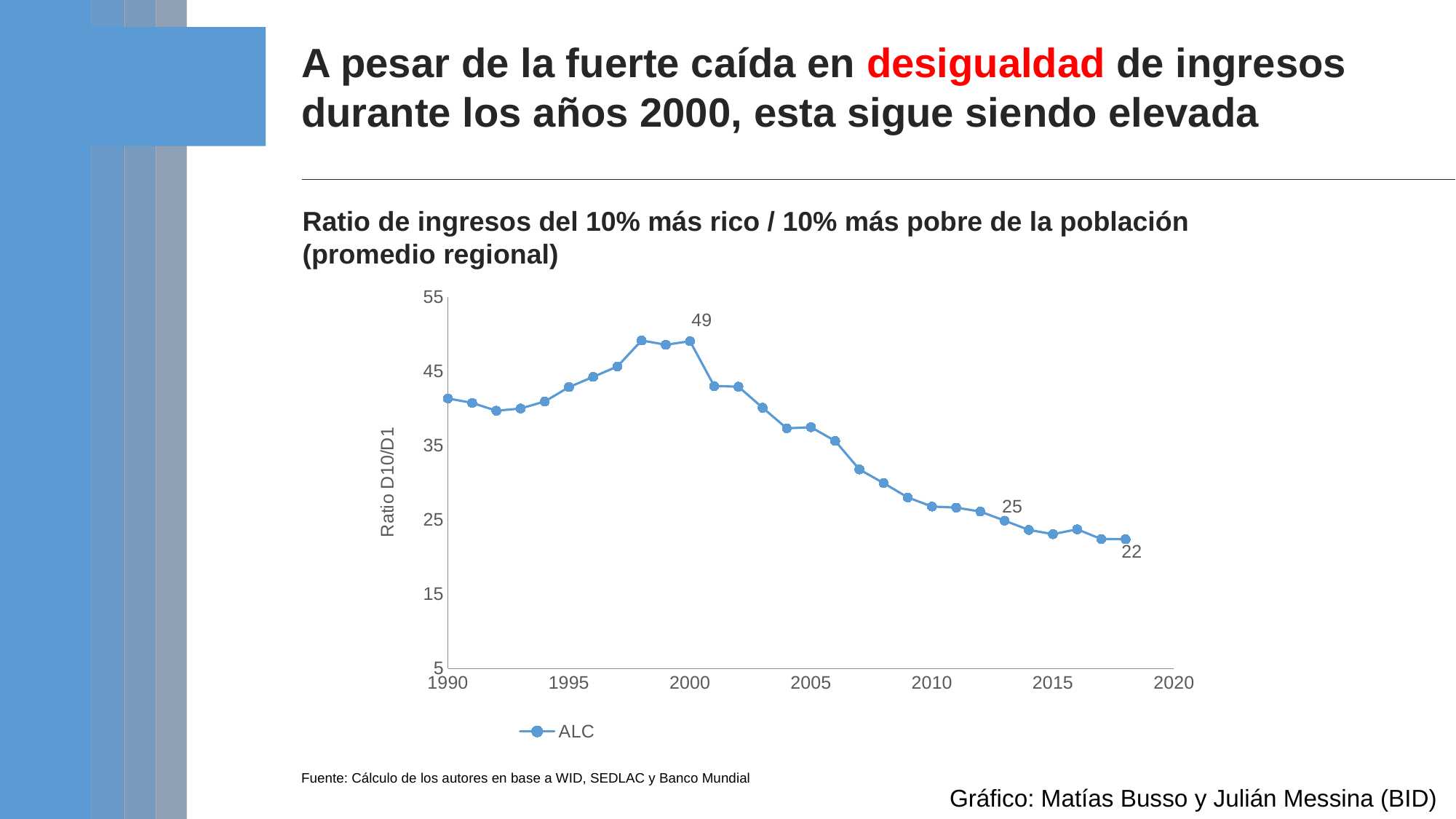
Is the ALC value for 1990 greater or less than 35? greater What is the difference between the ALC value in 2000 and the value in 2013? 24 What is the difference between the ALC value in 2000 and the value in 2018? 27 What is the value of the ALC series in 2018? 22 What is the value of the ALC series in 2013? 25 Do the ALC values rise or fall between 2000 and 2018? fall How many series does the legend list? 1 Is the ALC value for 2010 greater or less than 35? less What is the title of the vertical axis? Ratio D10/D1 What kind of chart is shown on the slide? line chart Which year has the larger ALC value, 2000 or 2018? 2000 What is the value of the ALC series in 2000? 49